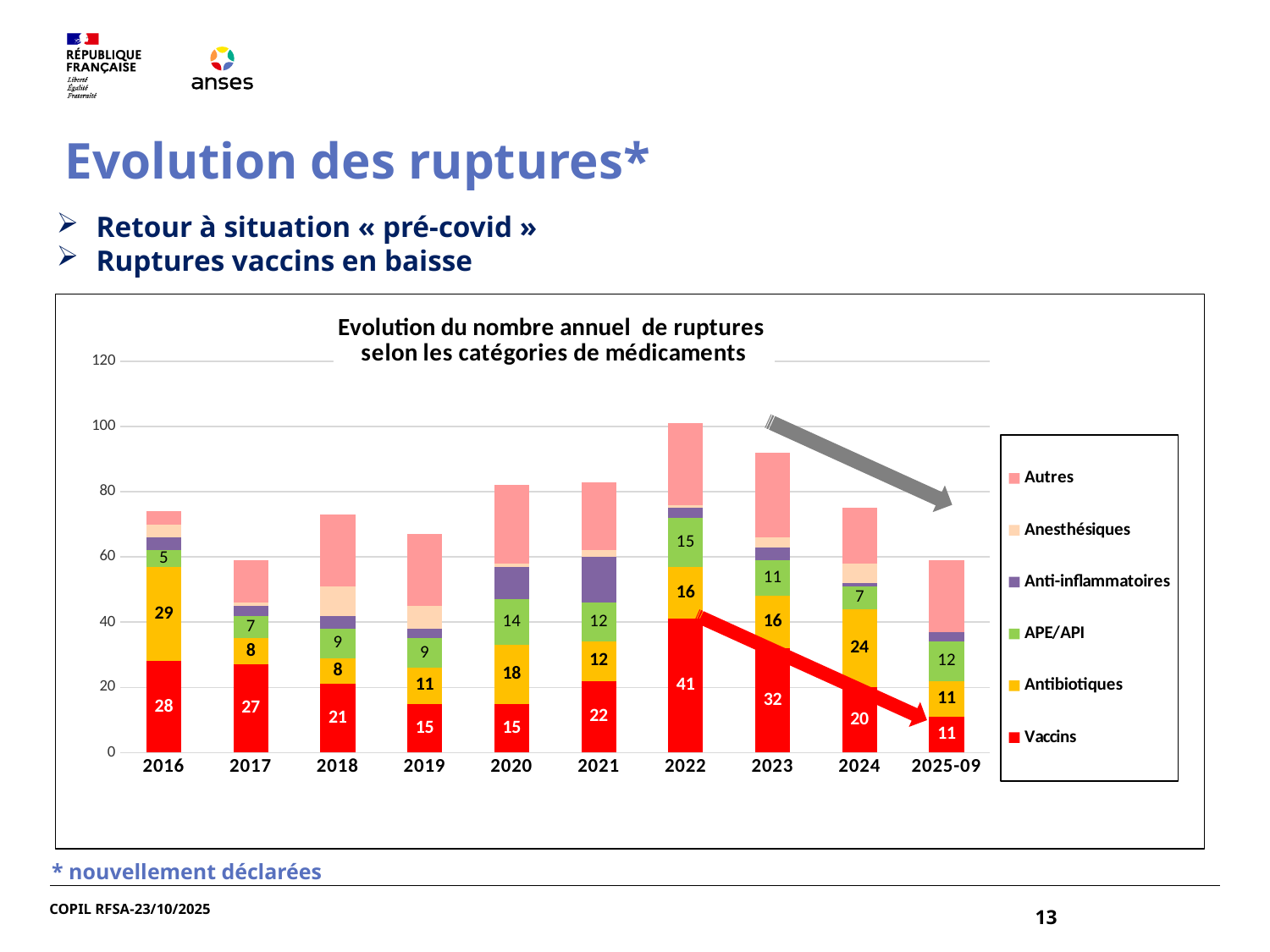
In which year is the Vaccins value highest? 2022 What type of chart is shown on the slide? Stacked bar chart In which year is the Antibiotiques value highest? 2016 What is the value for APE/API in 2020? 14 How many years (categories) are shown on the x axis? 10 What is the difference between the Vaccins values for 2022 and 2023? 9 How many series does the legend list? 6 In which year is the Vaccins value lowest? 2025-09 Which is larger, the APE/API value for 2020 or for 2021? 2020 Is the total height of the 2023 bar greater or less than 80? greater What is the value for Vaccins in 2022? 41 What is the value for Antibiotiques in 2024? 24